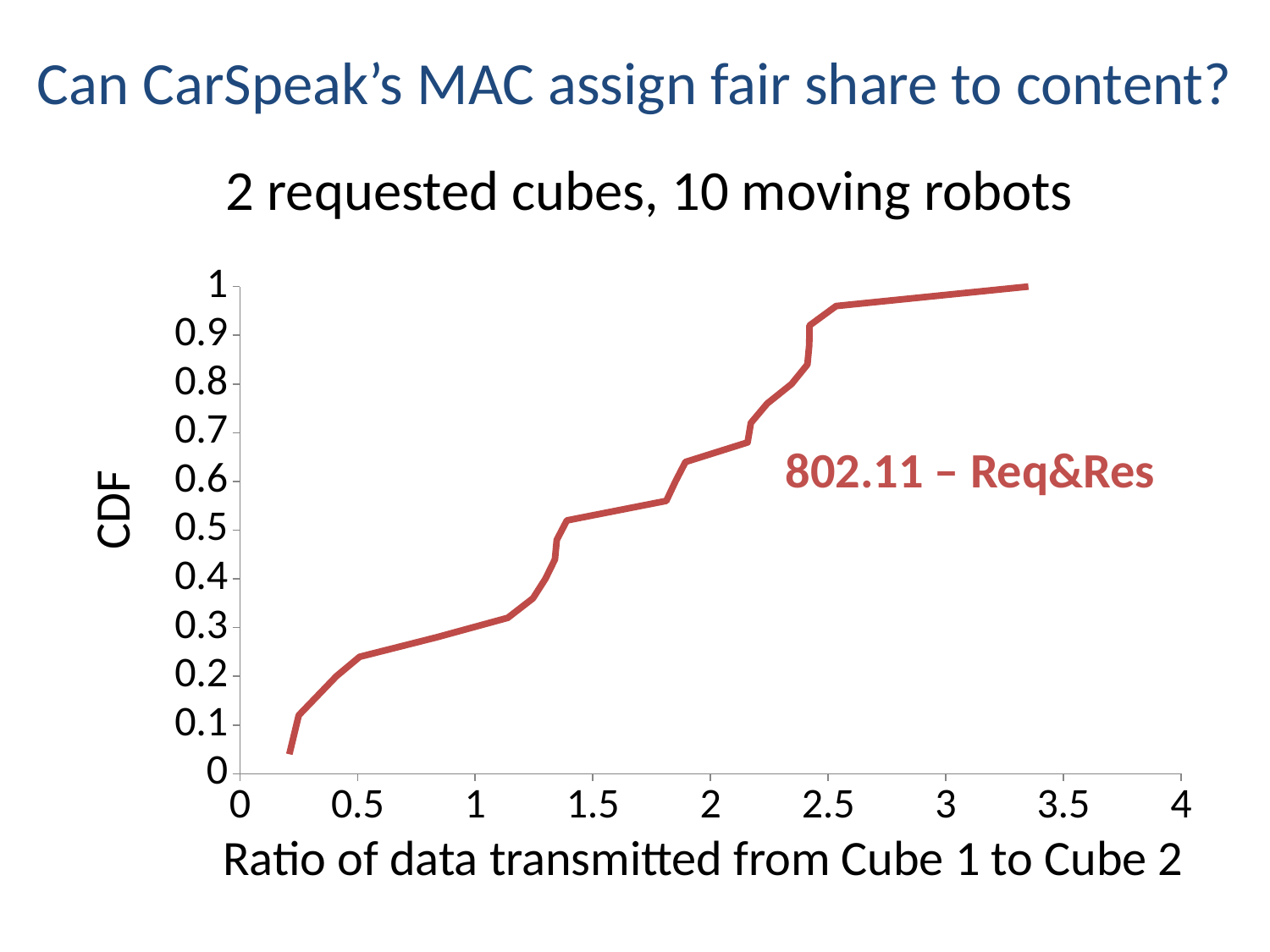
Is the largest ratio reached by the curve greater or less than 3.5? less What is the name of the series plotted on the chart? 802.11 – Req&Res Is the CDF value at a ratio of 1 greater or less than 0.2? greater What kind of chart is shown on the slide? line chart Is the CDF value at a ratio of 2 greater or less than 0.5? greater What is the label of the x axis? Ratio of data transmitted from Cube 1 to Cube 2 Does the CDF curve rise or fall as the ratio on the x axis increases? rise How many series are plotted on the chart? 1